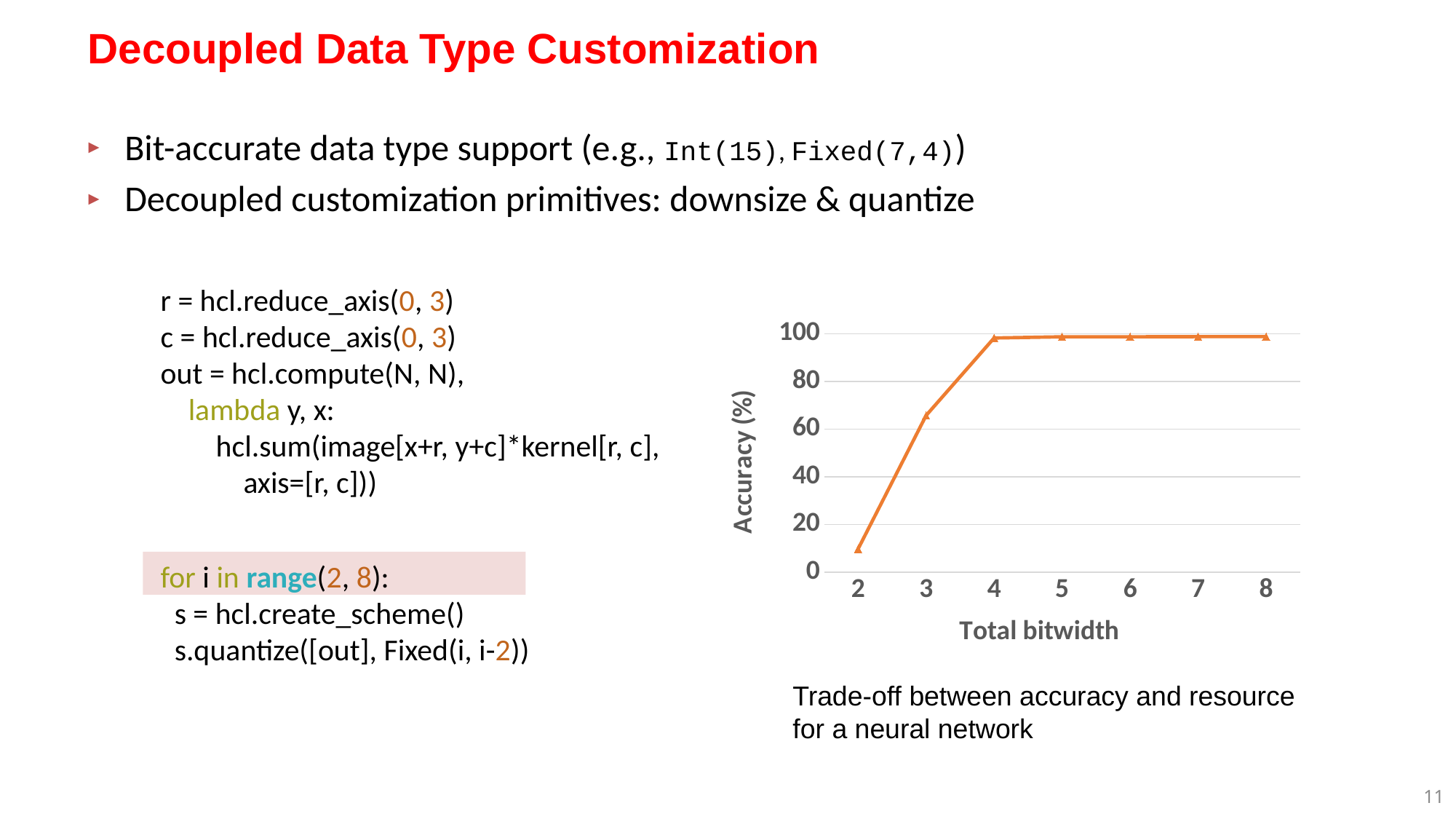
What is the label of the x axis of the chart? Total bitwidth Which has the higher accuracy, a total bitwidth of 2 or a total bitwidth of 3? 3 Is the accuracy at a total bitwidth of 3 greater or less than 60? greater Is the accuracy at a total bitwidth of 2 greater or less than 20? less Is the accuracy at a total bitwidth of 3 greater or less than 80? less Does accuracy rise or fall as total bitwidth increases from 2 to 4? rise How many data points are plotted on the line chart? 7 What is the label of the y axis of the chart? Accuracy (%) Which total bitwidth has the lowest accuracy? 2 What kind of chart is shown on the slide? line chart